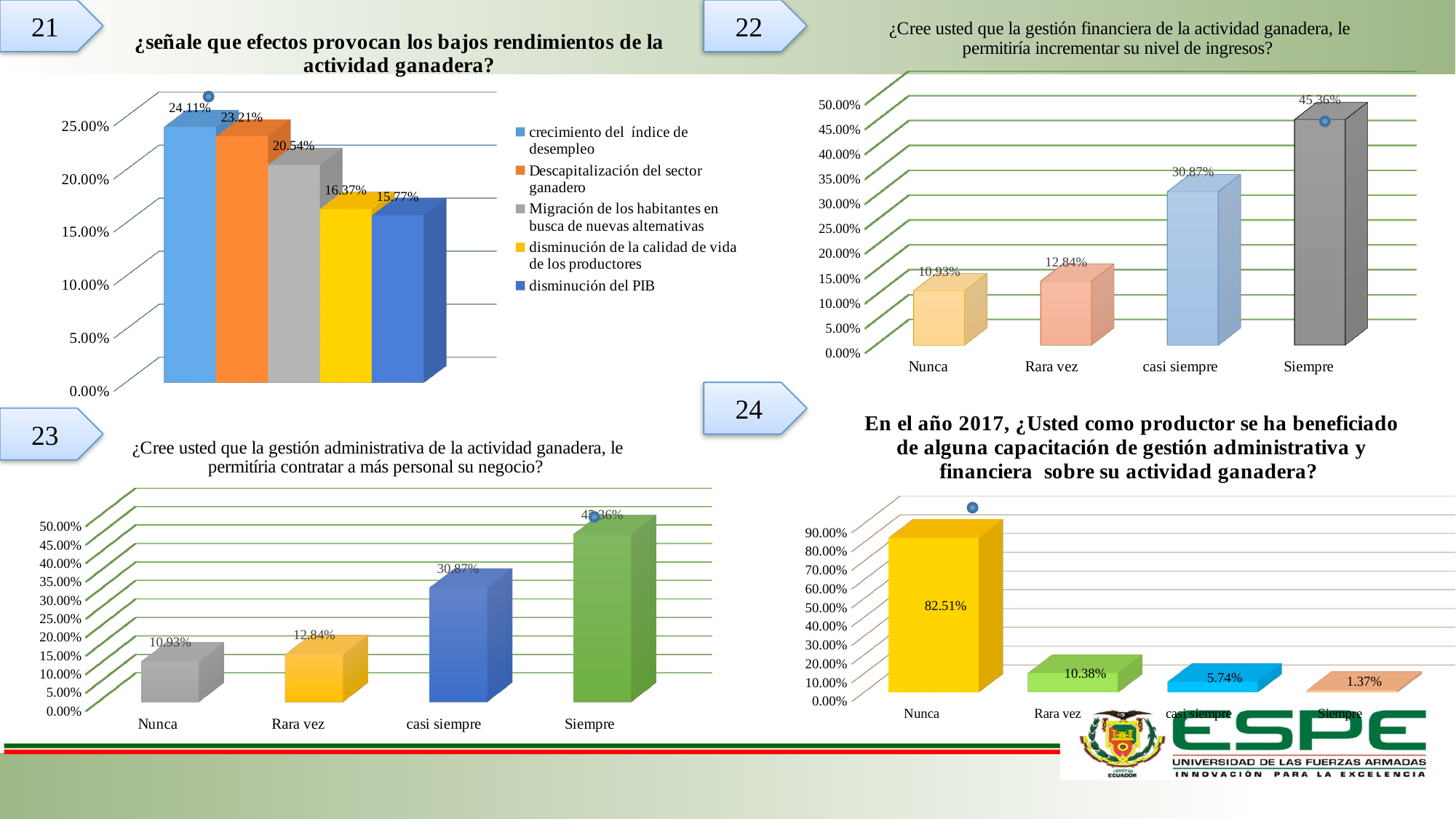
In the chart for question 22 (top-right), is the value for 'Siempre' greater or less than 40.00%? greater In the chart for question 23 (bottom-left), what is the value for 'Rara vez'? 12.84% In the chart for question 21 (top-left), what is the value for 'disminución del PIB'? 15.77% In the chart for question 23 (bottom-left), do the values rise or fall from 'Nunca' to 'Siempre'? rise In the chart for question 22 (top-right), which category has the lowest value? Nunca In the chart for question 24 (bottom-right), what is the difference between 'Rara vez' and 'casi siempre'? 4.64% In the chart for question 24 (bottom-right), what is the value for 'Nunca'? 82.51% In the chart for question 24 (bottom-right), which category has the lowest value? Siempre In the chart for question 21 (top-left), what is the difference between 'Descapitalización del sector ganadero' and 'disminución de la calidad de vida de los productores'? 6.84% In the chart for question 21 (top-left), how many entries does the legend list? 5 In the chart for question 21 (top-left), what is the value for 'crecimiento del índice de desempleo'? 24.11% In the chart for question 22 (top-right), what is the value for 'casi siempre'? 30.87%